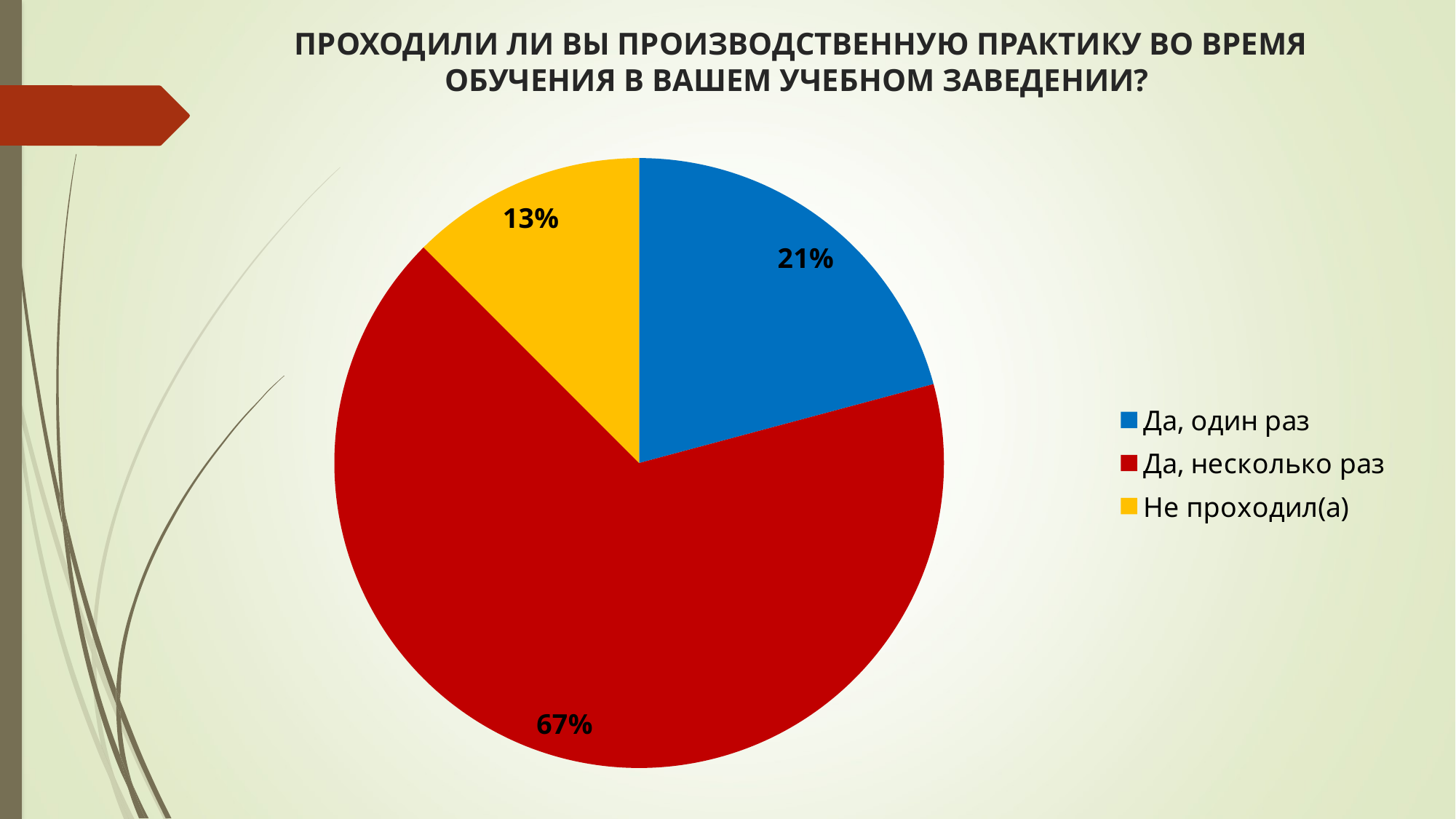
How many slices does the pie chart have? 3 Which answer option has the smallest share of the pie? Не проходил(а) What share of respondents answered "Да, несколько раз"? 67% What colour is the slice for "Да, несколько раз"? red Which is larger: the share for "Да, один раз" or the share for "Не проходил(а)"? Да, один раз What kind of chart is shown on the slide? pie chart What share of respondents answered "Да, один раз"? 21% What colour is the slice for "Не проходил(а)"? yellow How many entries does the legend list? 3 Which answer option has the largest share of the pie? Да, несколько раз What share of respondents answered "Не проходил(а)"? 13% What is the difference in percentage points between "Да, несколько раз" and "Да, один раз"? 46